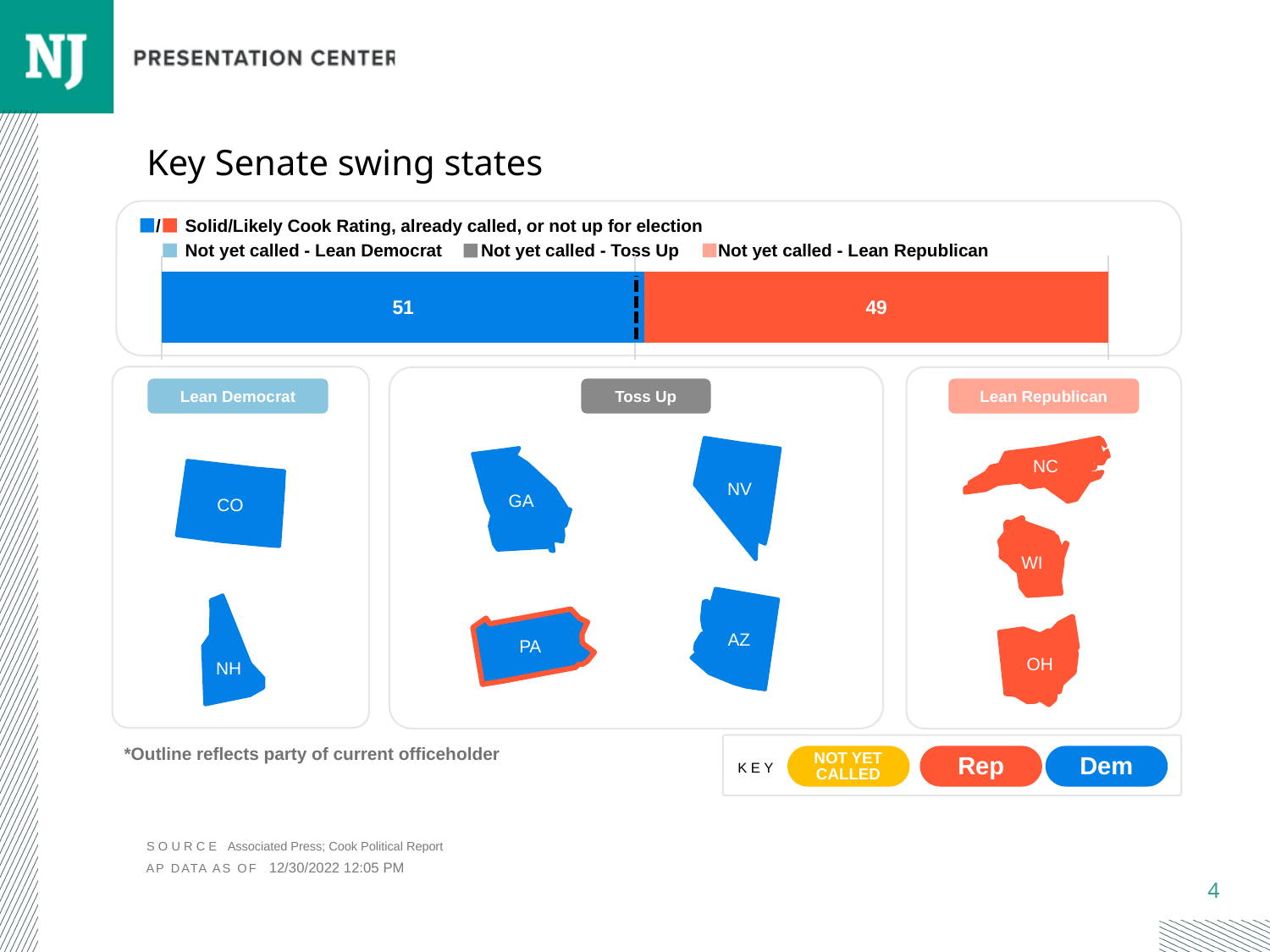
How many entries does the legend above the bar list? 4 Which segment of the bar is larger, the blue one or the red one? The blue one (51) What is the total of the two labelled segments in the stacked bar? 100 What is the difference between the blue segment value and the red segment value in the bar? 2 What does the light blue legend entry above the bar represent? Not yet called - Lean Democrat Is the value of the blue segment greater or less than 50? greater How many labelled segments does the stacked bar contain? 2 What is the title of the slide containing the bar chart? Key Senate swing states What kind of chart is shown at the top of the slide? A stacked horizontal bar chart What value is printed on the blue segment of the Senate seats bar? 51 Which segment of the bar has the highest value? The blue segment, 51 What value is printed on the red segment of the Senate seats bar? 49